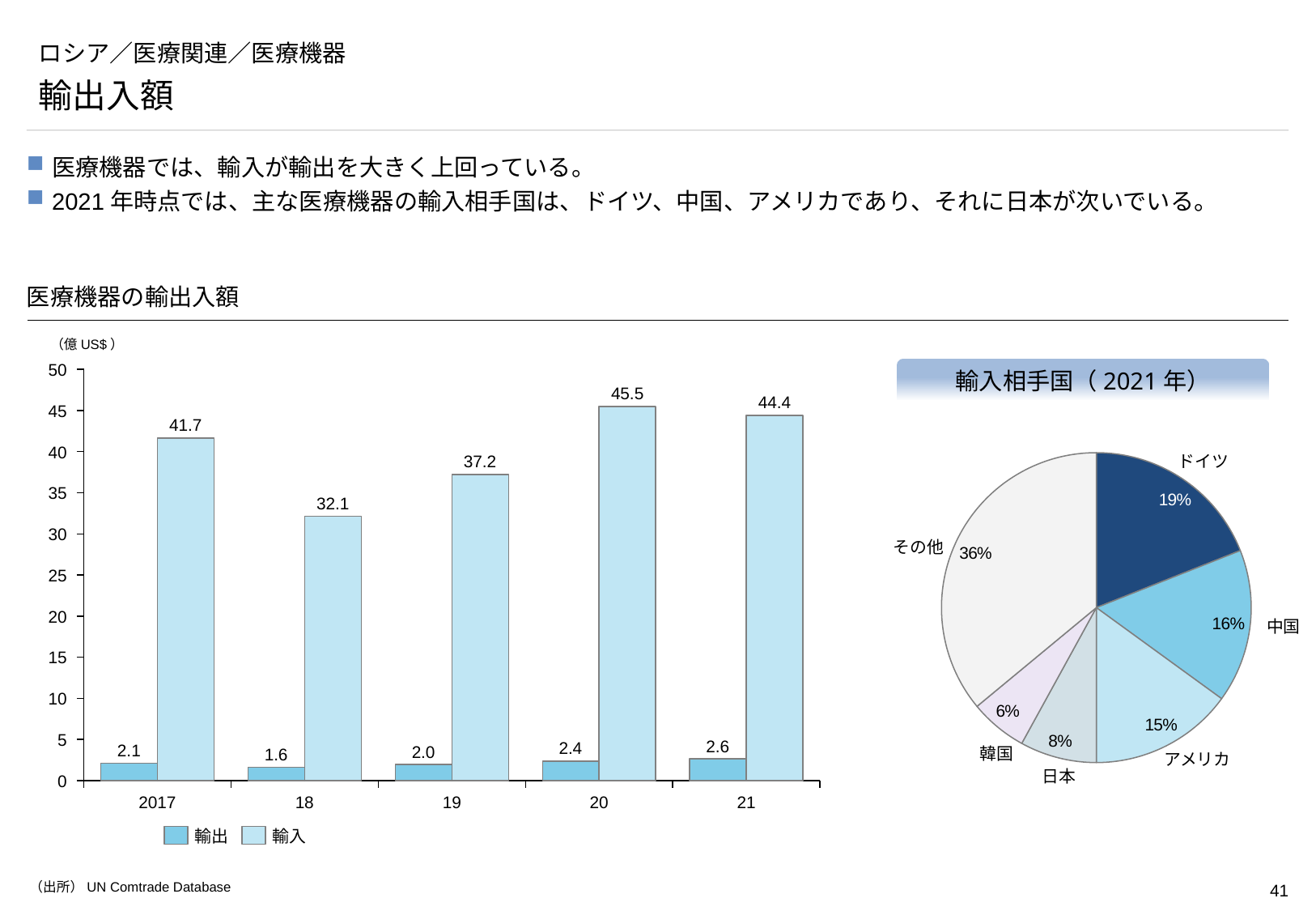
In the pie chart 輸入相手国（2021年）, what share does ドイツ have? 19% In the bar chart 医療機器の輸出入額, which year has the highest 輸入 value? 20 In the pie chart 輸入相手国（2021年）, which is larger, 中国 or アメリカ? 中国 In the bar chart 医療機器の輸出入額, what is the difference between 輸入 and 輸出 in 21? 41.8 In the bar chart 医療機器の輸出入額, is the 輸入 value for 19 greater or less than 35? greater What kind of chart is the chart on the left of the slide? bar chart In the bar chart 医療機器の輸出入額, what is the value of 輸入 for 2017? 41.7 In the bar chart 医療機器の輸出入額, how many years are shown on the x axis? 5 In the bar chart 医療機器の輸出入額, which year has the lowest 輸出 value? 18 In the pie chart 輸入相手国（2021年）, which slice is the largest? その他 In the bar chart 医療機器の輸出入額, how many series does the legend list? 2 In the bar chart 医療機器の輸出入額, what is the value of 輸出 for 21? 2.6